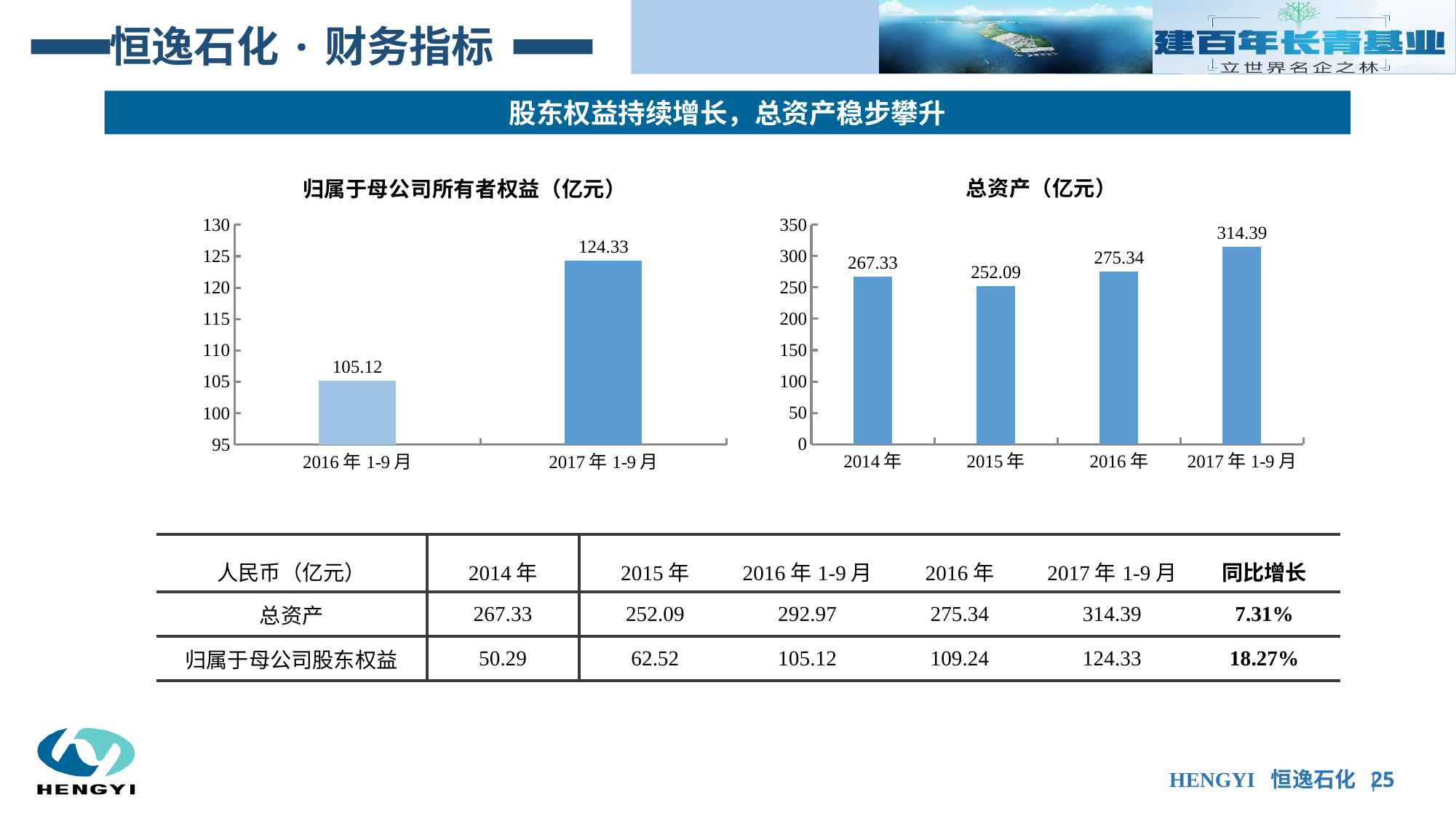
In the chart titled 总资产（亿元）, what is the value for 2016年? 275.34 In the chart titled 归属于母公司所有者权益（亿元）, what is the value for 2017年1-9月? 124.33 In the chart titled 总资产（亿元）, which category has the highest value? 2017年1-9月 What type of chart is the one titled 总资产（亿元）? Bar chart In the chart titled 归属于母公司所有者权益（亿元）, how many bars are plotted? 2 In the chart titled 归属于母公司所有者权益（亿元）, what is the difference between the 2017年1-9月 and 2016年1-9月 values? 19.21 In the chart titled 总资产（亿元）, what is the difference between the 2017年1-9月 and 2014年 values? 47.06 In the chart titled 总资产（亿元）, how many categories are shown on the x axis? 4 In the chart titled 归属于母公司所有者权益（亿元）, what is the value for 2016年1-9月? 105.12 In the chart titled 总资产（亿元）, which category has the lowest value? 2015年 In the chart titled 总资产（亿元）, which is larger, the value for 2014年 or the value for 2016年? 2016年 In the chart titled 总资产（亿元）, what is the value for 2015年? 252.09